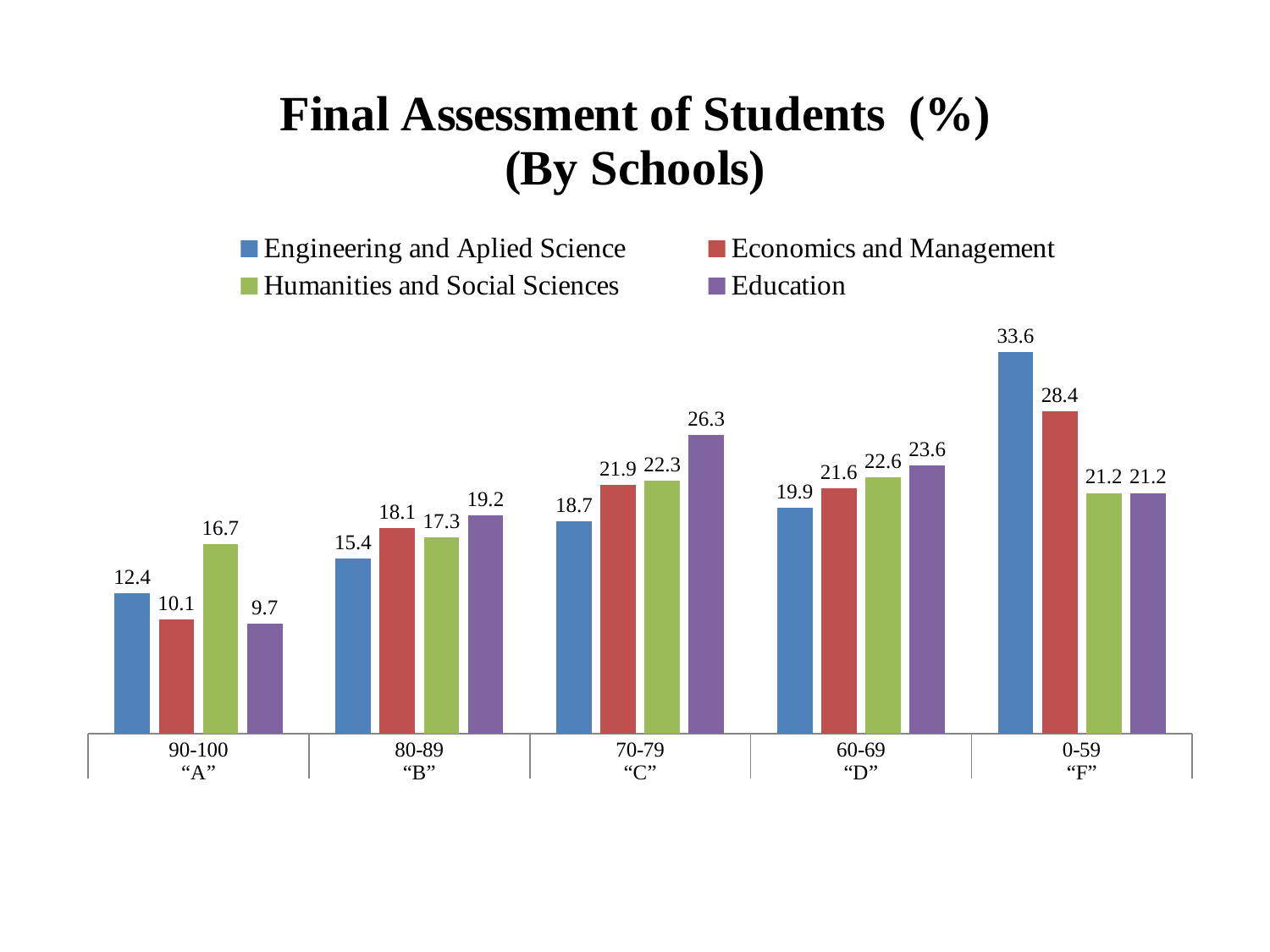
What is the difference between Engineering and Aplied Science and Economics and Management in the 0-59 "F" category? 5.2 What kind of chart is shown on the slide? Bar chart How many grade categories are shown on the x axis? 5 What is the value for Education in the 90-100 "A" category? 9.7 Which is larger in the 90-100 "A" category: Humanities and Social Sciences or Engineering and Aplied Science? Humanities and Social Sciences Which category has the lowest value for Education? 90-100 "A" Do the values for Economics and Management rise or fall from the 90-100 "A" category to the 0-59 "F" category? Rise What is the value for Economics and Management in the 70-79 "C" category? 21.9 What is the value for Humanities and Social Sciences in the 80-89 "B" category? 17.3 What is the value for Engineering and Aplied Science in the 0-59 "F" category? 33.6 How many series does the legend list? 4 Which category has the highest value for Engineering and Aplied Science? 0-59 "F"